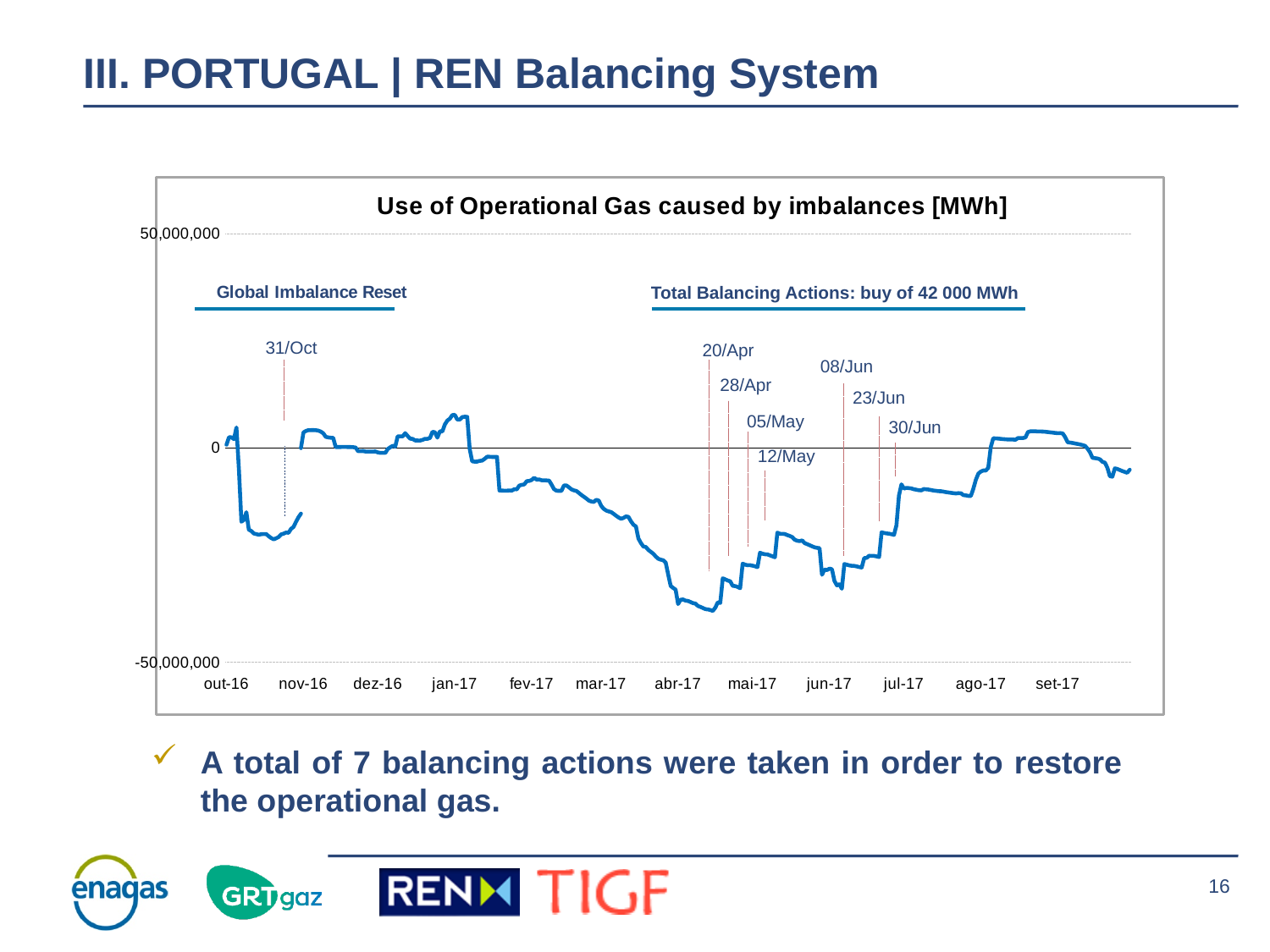
What is the title of the chart? Use of Operational Gas caused by imbalances [MWh] Is the value of the line around ago-17 greater or less than 0? greater Around which month label does the line reach its lowest point? abr-17 Does the line rise or fall between fev-17 and abr-17? fall On what date is the Global Imbalance Reset marked on the chart? 31/Oct Does the line rise or fall between mai-17 and jul-17? rise How many month labels are shown on the x axis of the chart? 12 Is the value of the line around abr-17 greater or less than 0? less What is the highest value shown on the y axis of the chart? 50,000,000 What is the lowest value shown on the y axis of the chart? -50,000,000 What kind of chart is shown on the slide? line chart